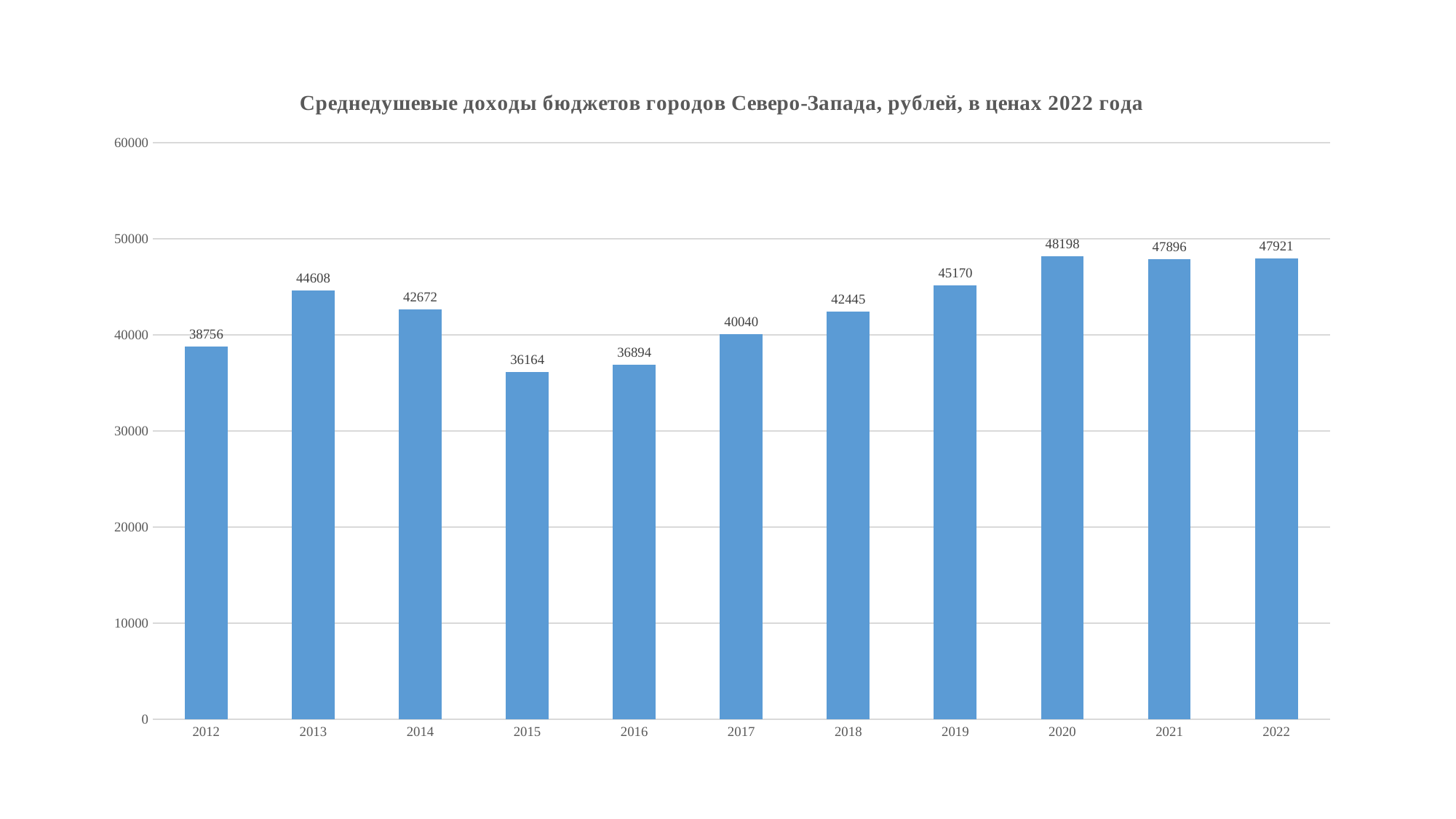
What is the title of the chart? Среднедушевые доходы бюджетов городов Северо-Запада, рублей, в ценах 2022 года Is the value for 2016 greater or less than 40000? less What is the value for 2020? 48198 What is the difference between the values for 2013 and 2012? 5852 What kind of chart is this? bar chart Which year has the lowest value? 2015 What is the difference between the values for 2020 and 2015? 12034 What is the value for 2012? 38756 How many years are shown on the x axis? 11 What is the value for 2017? 40040 Which is larger, the value for 2014 or the value for 2018? 2014 Which year has the highest value? 2020